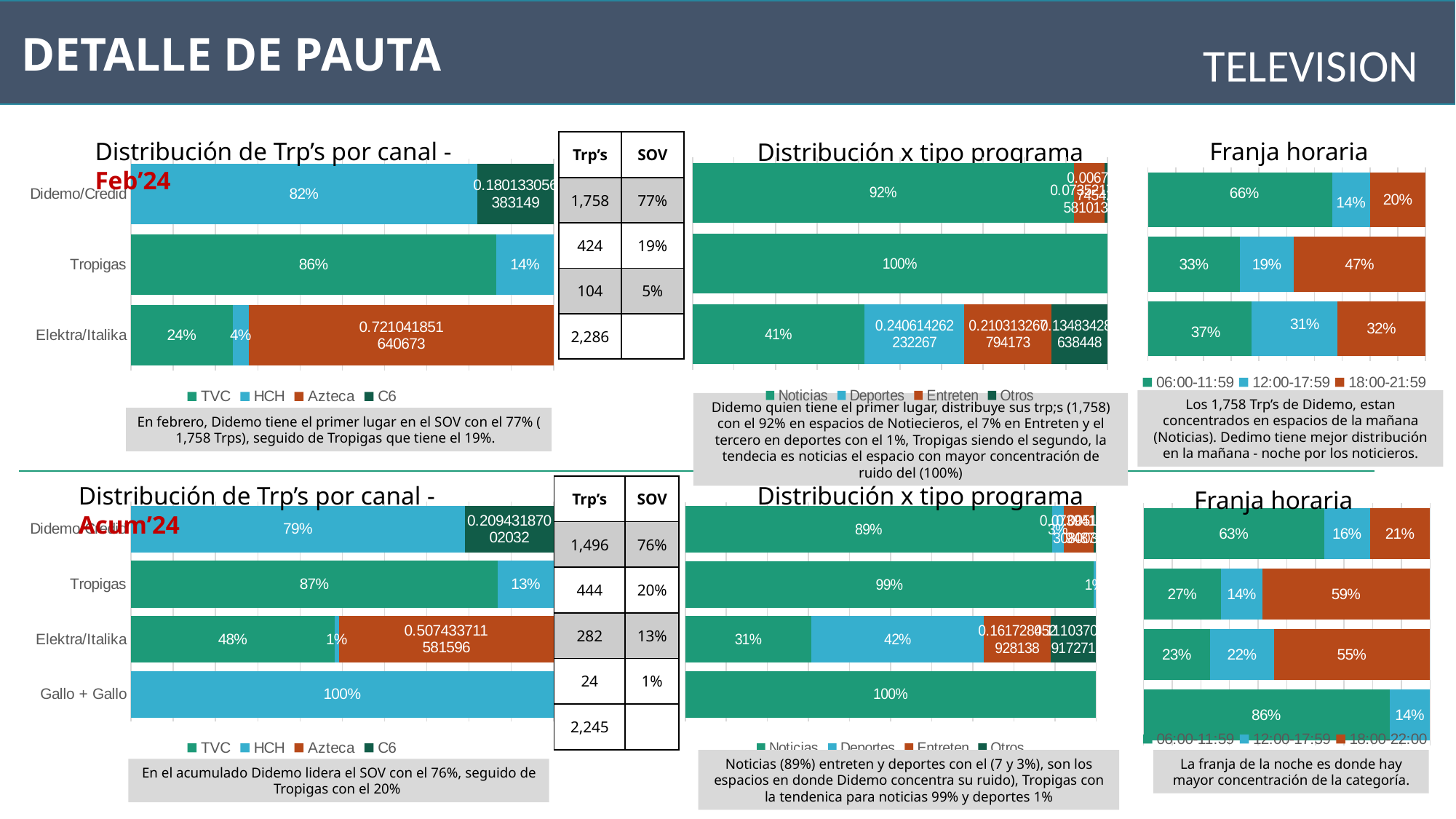
In the top 'Distribución de Trp's por canal - Feb'24' chart, what is the HCH value for Didemo/Credid? 82% In the top 'Distribución x tipo programa' chart, what is the Noticias value for Tropigas? 100% In the bottom 'Distribución x tipo programa' chart, which is larger for Elektra/Italika: Noticias or Deportes? Deportes In the bottom 'Franja horaria' chart, what is the 18:00-22:00 value for Tropigas? 59% In the top 'Distribución de Trp's por canal - Feb'24' chart, how many series does the legend list? 4 In the top 'Franja horaria' chart, what is the difference between the 06:00-11:59 and 12:00-17:59 values for Didemo/Credid? 52% In the top 'Franja horaria' chart, what is the 18:00-21:59 value for Tropigas? 47% In the bottom 'Distribución de Trp's por canal - Acum'24' chart, what is the HCH value for Gallo + Gallo? 100% In the top 'Franja horaria' chart, which time slot has the highest value for Didemo/Credid? 06:00-11:59 In the bottom 'Distribución de Trp's por canal - Acum'24' chart, how many channel categories are shown? 4 In the top 'Distribución de Trp's por canal - Feb'24' chart, what is the TVC value for Tropigas? 86% In the top 'Distribución x tipo programa' chart, what is the Noticias value for Elektra/Italika? 41%